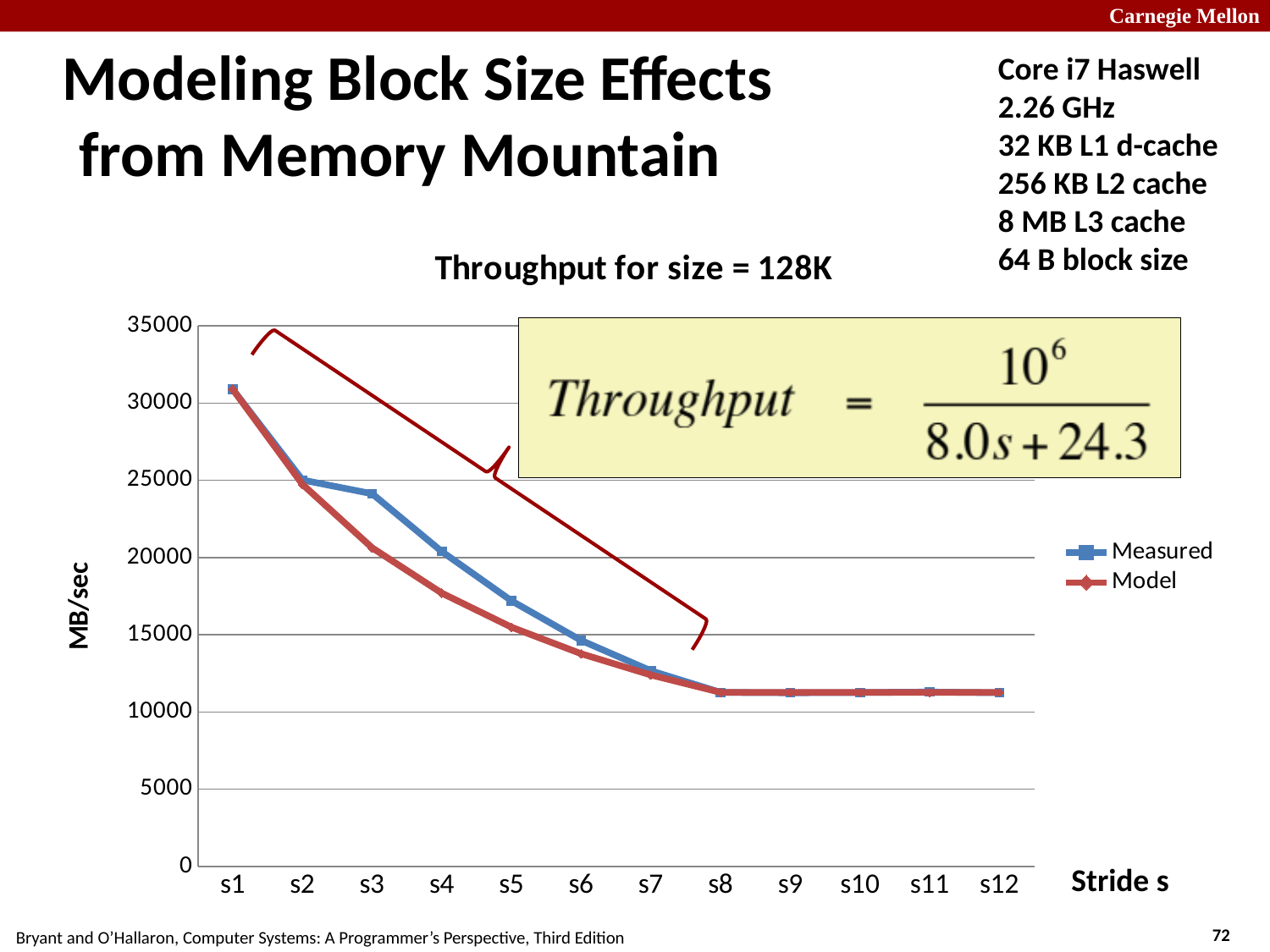
Is the Model value at s3 greater or less than 25000? less What is the title of the chart? Throughput for size = 128K Do the Measured values rise or fall as the stride increases from s1 to s8? fall At stride s3, which series has the larger value, Measured or Model? Measured Is the Measured value at s1 greater or less than 25000? greater How many series does the legend list? 2 Is the Measured value at s8 greater or less than 15000? less At stride s4, which series has the larger value, Measured or Model? Measured How many stride values are plotted along the x axis? 12 At which stride is the Measured throughput highest? s1 What kind of chart is shown on the slide? line chart